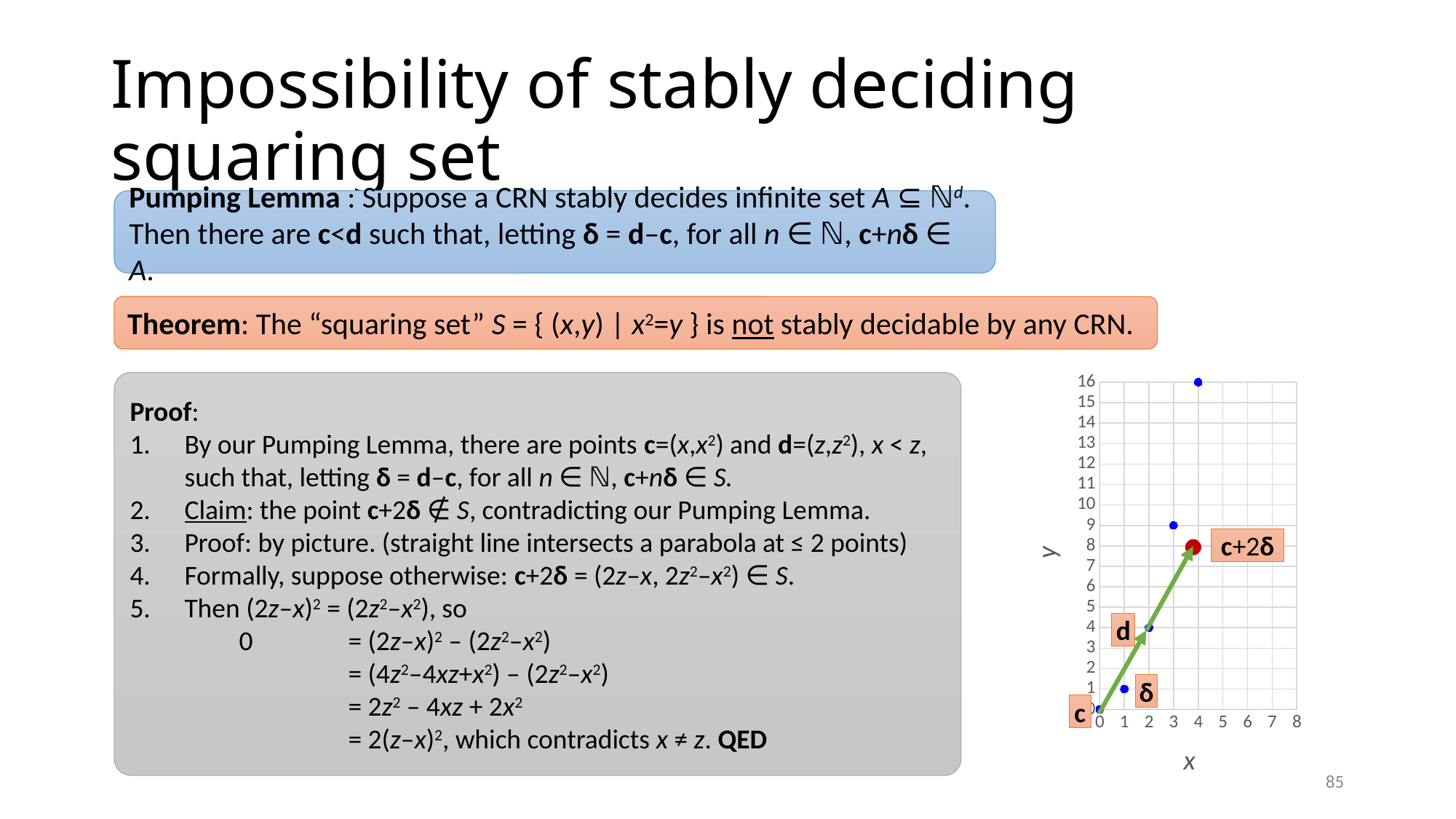
What is the label on the vertical axis of the chart? y Is the y value of the blue point at x = 4 greater or less than 10? greater What is the y value of the red point labelled c+2δ? 8 What kind of chart is shown on the right of the slide? scatter chart What is the label on the horizontal axis of the chart? x Do the blue points rise or fall as x increases? rise What is the y value of the highest blue point on the chart? 16 How many blue points are plotted on the chart? 5 Which has the larger y value: the blue point at x = 3 or the red point c+2δ? the blue point at x = 3 What is the x value of the red point labelled c+2δ? 4 What is the difference in y between the blue point at x = 4 and the red point c+2δ? 8 What is the y value of the blue point at x = 3? 9